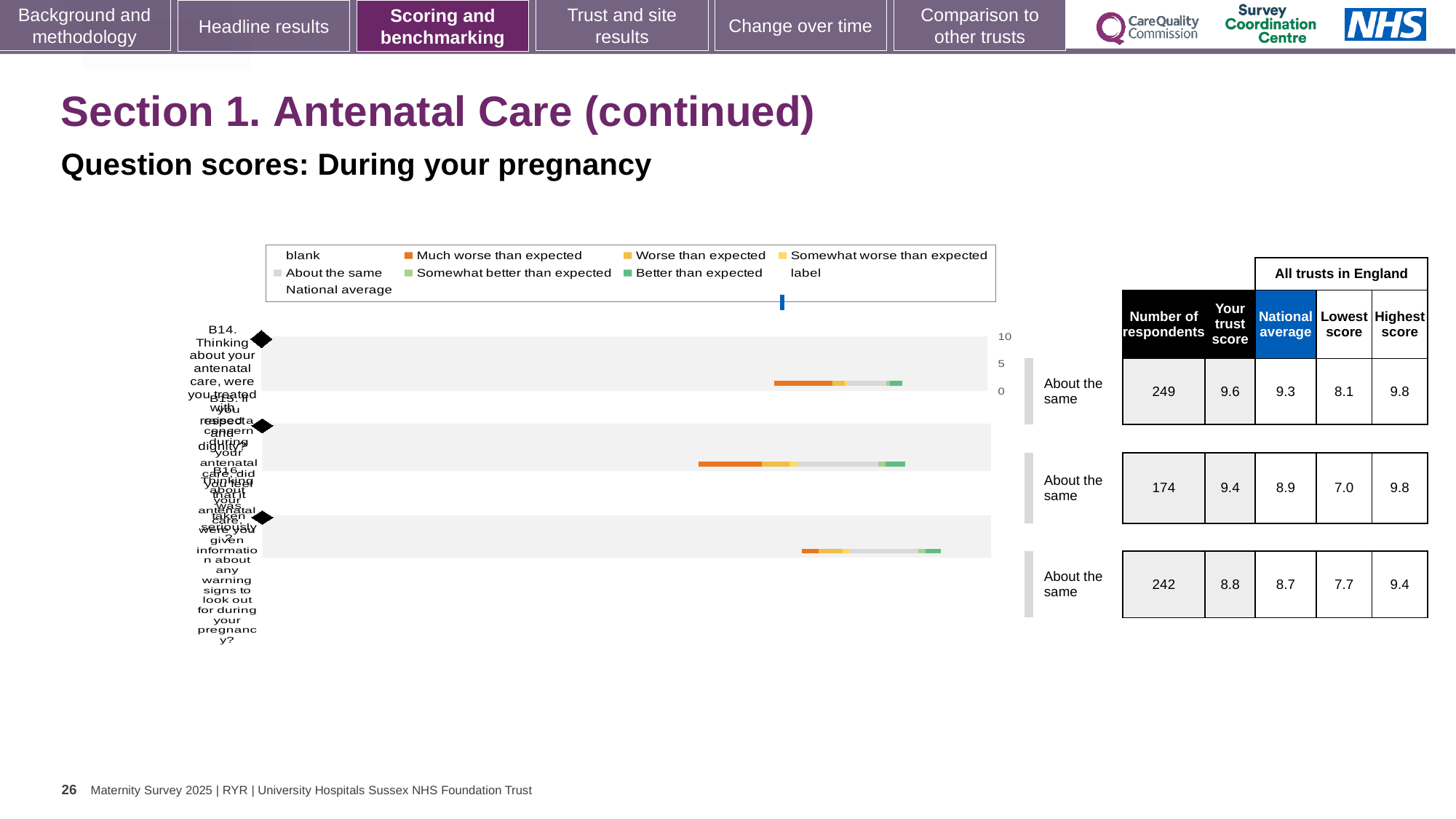
What is the highest score across all trusts in England for the third row of the chart? 9.4 Which row has the highest trust score? The top row (B14) What is the national average for the second row of the chart? 8.9 How many questions (bars) are plotted in the chart? 3 What benchmark category is shown for each of the three rows? About the same For the second row, which is larger: the trust score or the national average? The trust score (9.4) How many entries does the chart legend list? 9 What is the trust score for the top row (B14, treated with respect and dignity)? 9.6 Which row has the lowest 'Lowest score' value? The second row (7.0) What is the number of respondents for the top row (B14, treated with respect and dignity)? 249 What kind of chart is shown on the slide? Bar chart What is the difference between the trust score and the national average for the top row? 0.3